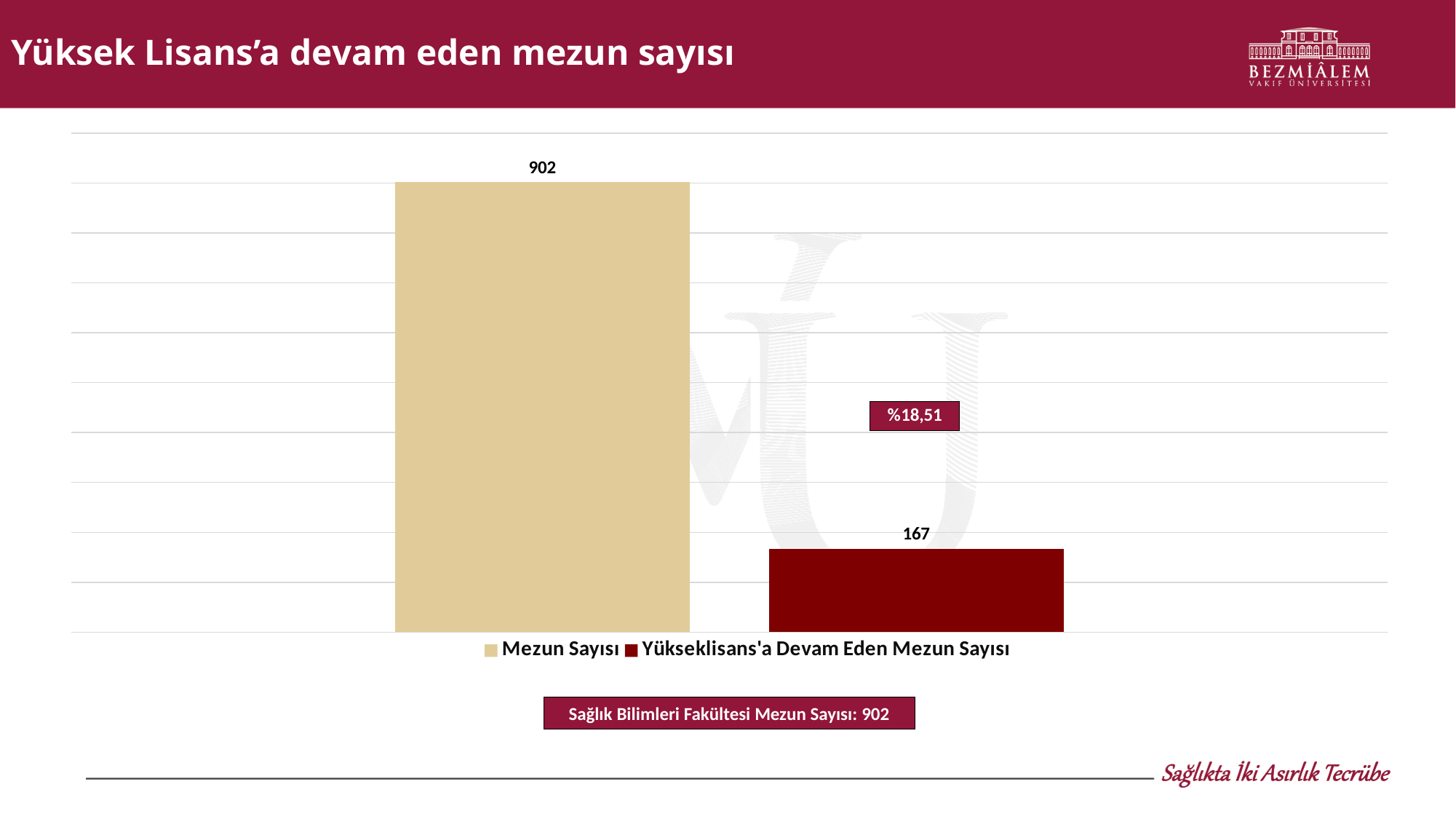
What kind of chart is shown on the slide? Bar chart What is the title of the slide? Yüksek Lisans'a devam eden mezun sayısı What is the value for Yükseklisans'a Devam Eden Mezun Sayısı? 167 Which series has the lowest value? Yükseklisans'a Devam Eden Mezun Sayısı What is the value for Mezun Sayısı? 902 How many bars are plotted on the chart? 2 What is the difference between Mezun Sayısı and Yükseklisans'a Devam Eden Mezun Sayısı? 735 What percentage is shown in the label between the two bars? %18,51 Which series has the highest value? Mezun Sayısı Which series has the higher value, Mezun Sayısı or Yükseklisans'a Devam Eden Mezun Sayısı? Mezun Sayısı How many series does the legend list? 2